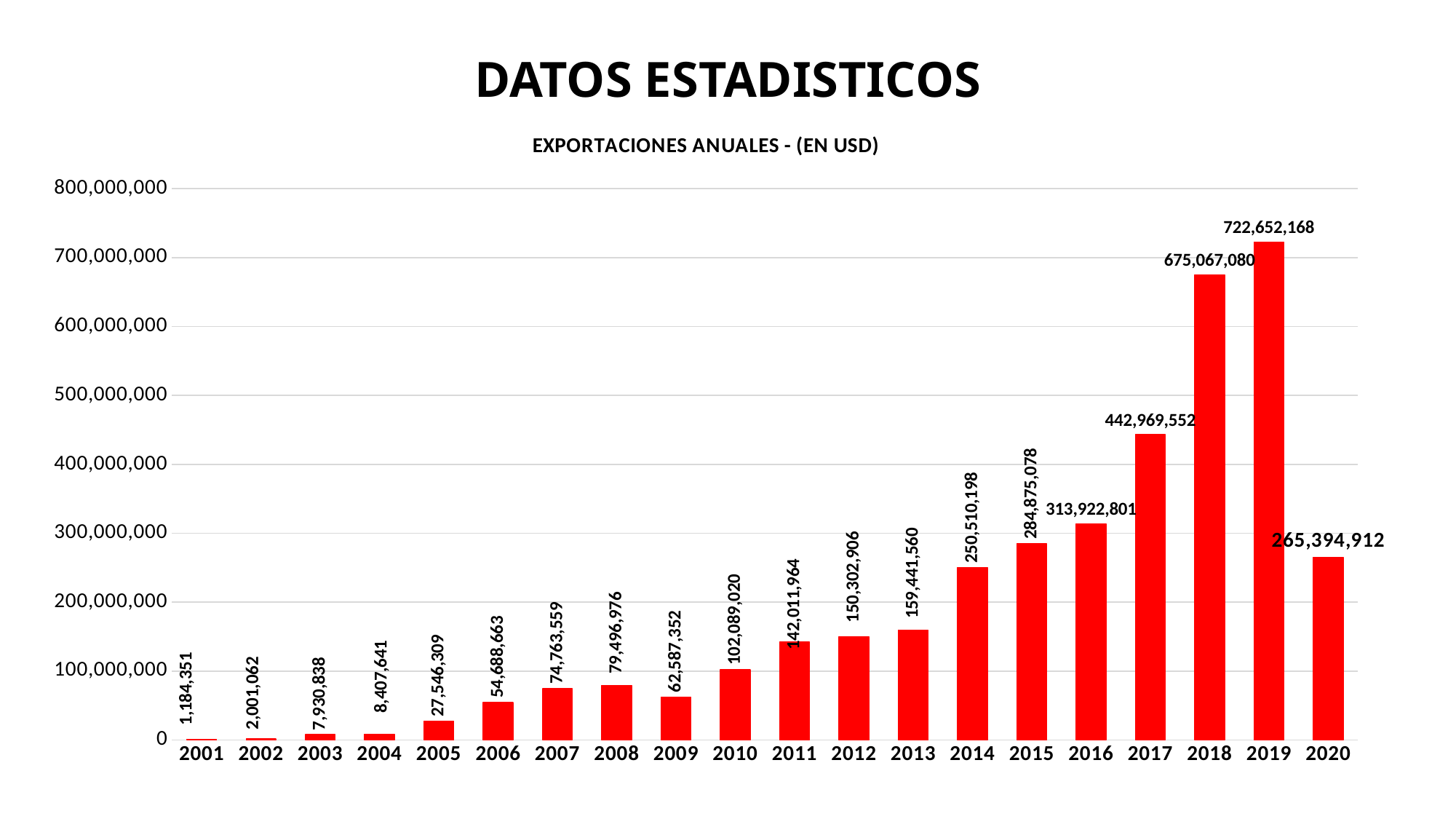
What is the value for 2019 in the chart? 722,652,168 What is the difference between the values for 2008 and 2009? 16,909,624 Is the value for 2017 greater or less than 400,000,000? greater What is the value for 2005 in the chart? 27,546,309 Do the values rise or fall from 2010 to 2019? rise Which year has the lowest value in the chart? 2001 Which is larger, the value for 2016 or the value for 2020? 2016 How many years are shown on the x axis of the chart? 20 What is the value for 2020 in the chart? 265,394,912 What kind of chart is shown on the slide? bar chart Which year has the highest value in the chart? 2019 What is the difference between the values for 2019 and 2018? 47,585,088